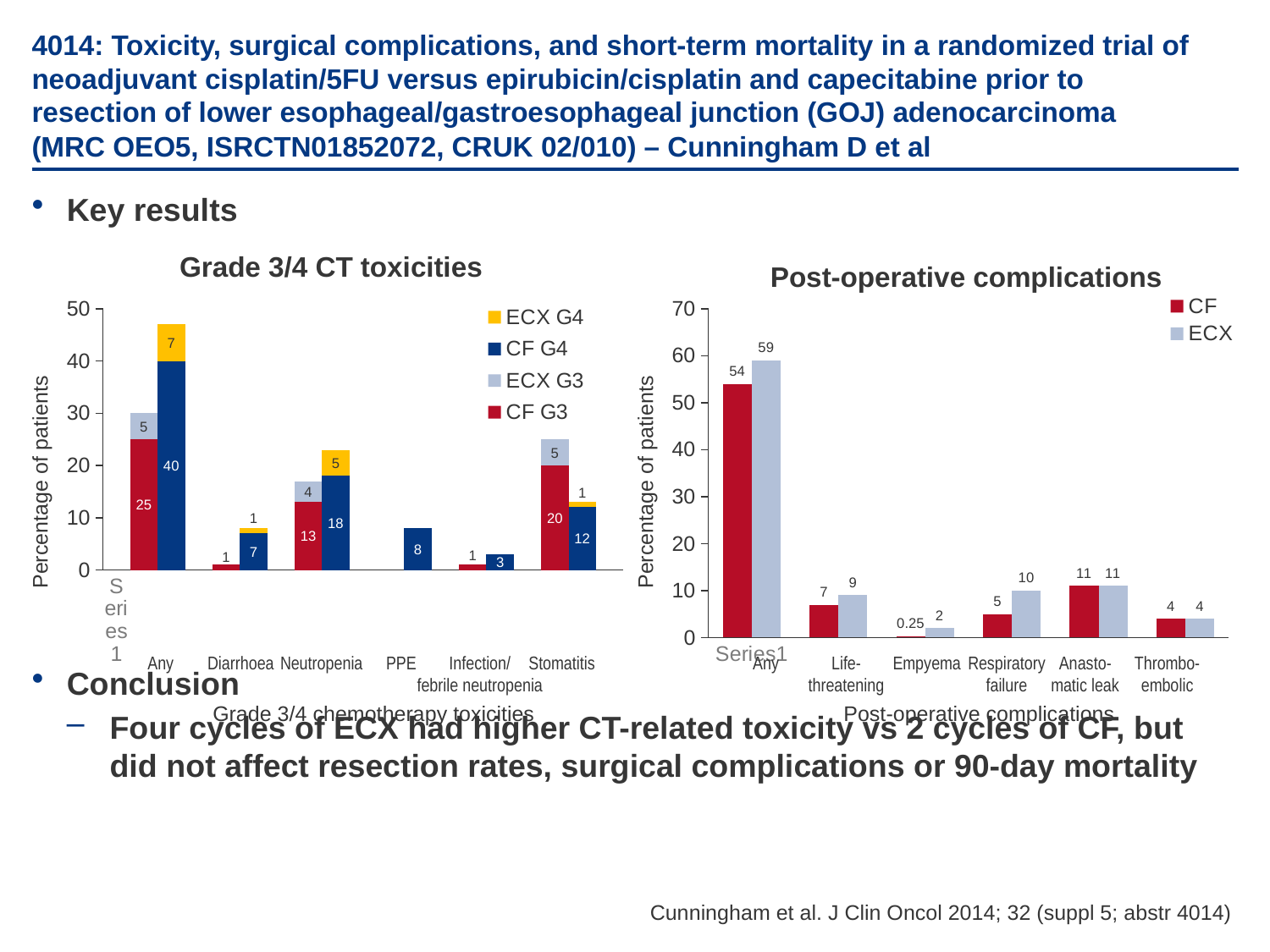
In the Post-operative complications chart, which category has the highest value for ECX? Any In the Post-operative complications chart, what is the difference between the ECX and CF values for the Any category? 5 What kind of chart is the Grade 3/4 CT toxicities chart? Stacked bar chart In the Post-operative complications chart, what is the value for ECX for Respiratory failure? 10 In the Grade 3/4 CT toxicities chart, what value is labelled on the CF G3 segment for Stomatitis? 20 In the Grade 3/4 CT toxicities chart, how many series does the legend list? 4 In the Post-operative complications chart, which is larger for Life-threatening complications, CF or ECX? ECX In the Post-operative complications chart, which category has the lowest value for CF? Empyema In the Post-operative complications chart, how many series does the legend list? 2 In the Post-operative complications chart, how many complication categories are shown on the x axis? 6 In the Post-operative complications chart, what is the value for CF for Empyema? 0.25 In the Post-operative complications chart, what is the value for CF in the Any category? 54